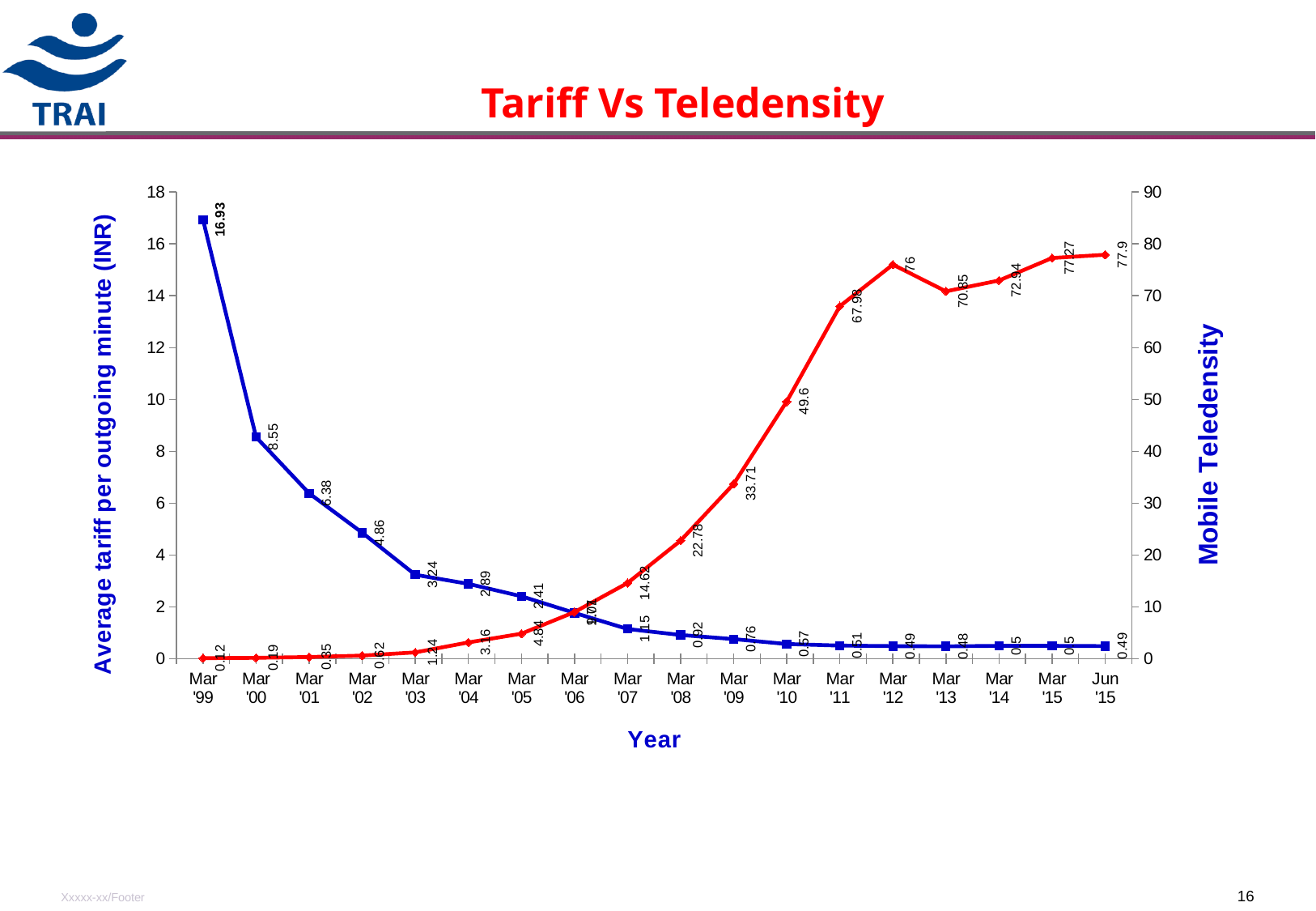
What is the mobile teledensity in Mar '10? 49.6 In which year is the mobile teledensity lowest? Mar '99 How many time points are plotted on the x axis? 18 In which year is the average tariff per outgoing minute highest? Mar '99 Does the average tariff per outgoing minute rise or fall from Mar '99 to Mar '13? fall What is the average tariff per outgoing minute in Mar '03? 3.24 By how much did the average tariff per outgoing minute fall from Mar '99 to Mar '00? 8.38 Which year has the higher mobile teledensity, Mar '12 or Mar '13? Mar '12 What is the mobile teledensity in Jun '15? 77.9 What is the average tariff per outgoing minute in Mar '99? 16.93 In which year is the mobile teledensity highest? Jun '15 What kind of chart is shown on the slide? line chart